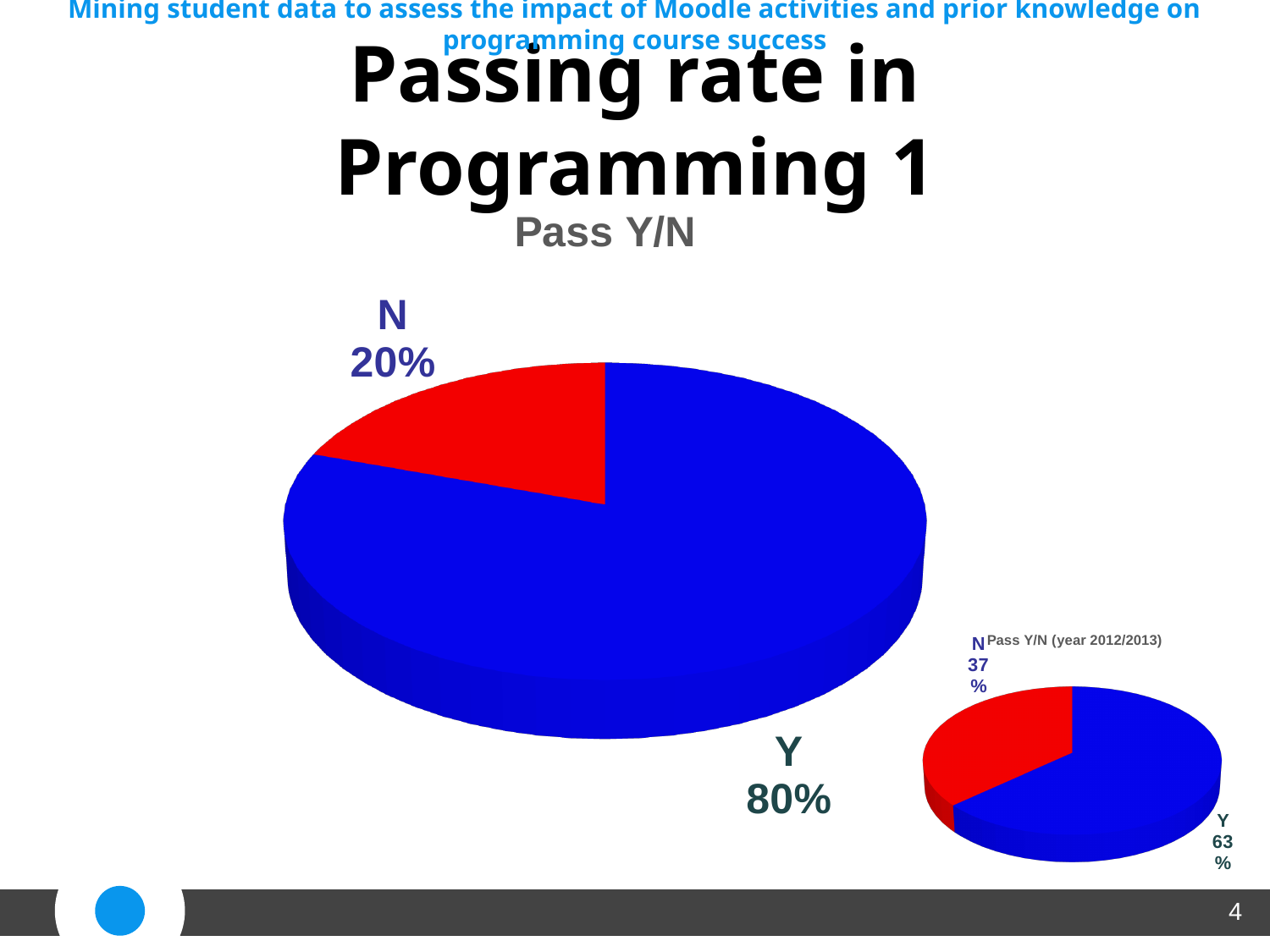
In the large 'Pass Y/N' pie chart, what share is labelled for N? 20% In the small 'Pass Y/N (year 2012/2013)' pie chart, what share is labelled for Y? 63% In the large 'Pass Y/N' pie chart, how many slices are there? 2 In the small 'Pass Y/N (year 2012/2013)' pie chart, what share is labelled for N? 37% What kind of chart is the large 'Pass Y/N' chart? Pie chart In the large 'Pass Y/N' pie chart, which slice is the largest? Y In the small 'Pass Y/N (year 2012/2013)' pie chart, what is the difference in percentage points between Y and N? 26 In the small 'Pass Y/N (year 2012/2013)' pie chart, which slice is larger, Y or N? Y In the large 'Pass Y/N' pie chart, what is the difference in percentage points between Y and N? 60 In the large 'Pass Y/N' pie chart, which slice is the smallest? N In the large 'Pass Y/N' pie chart, what colour is the N slice? Red In the large 'Pass Y/N' pie chart, what share is labelled for Y? 80%